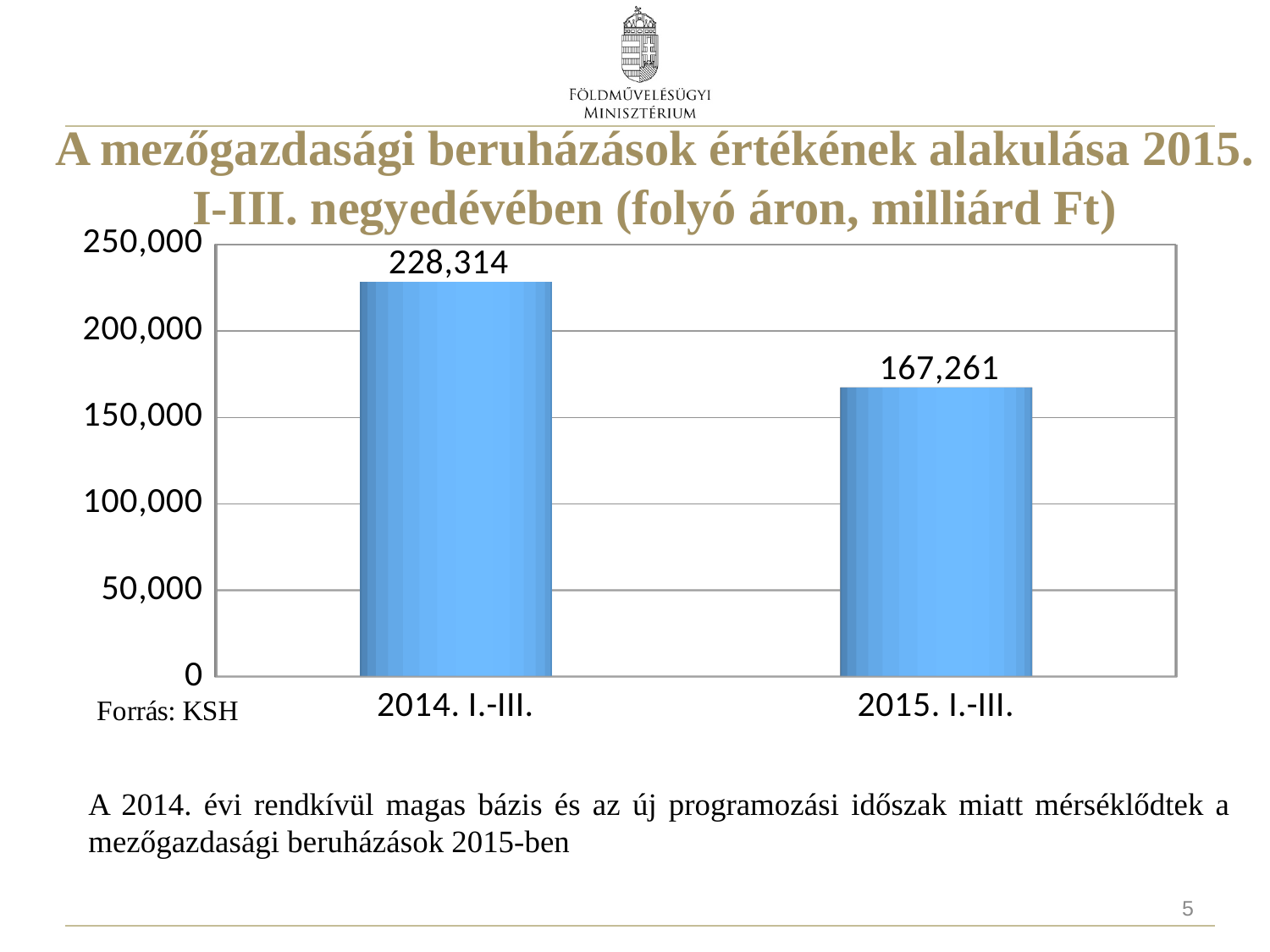
What is the difference between the values for 2014. I.-III. and 2015. I.-III.? 61,053 How many categories are shown on the x axis? 2 Which category has the highest value? 2014. I.-III. Do the values rise or fall from 2014. I.-III. to 2015. I.-III.? fall What is the value for 2014. I.-III.? 228,314 What is the value for 2015. I.-III.? 167,261 Is the value for 2015. I.-III. greater or less than 200,000? less What kind of chart is shown on the slide? bar chart What is the source cited below the chart? KSH Is the value for 2014. I.-III. greater or less than 200,000? greater Which is larger, the value for 2014. I.-III. or the value for 2015. I.-III.? 2014. I.-III. Which category has the lowest value? 2015. I.-III.